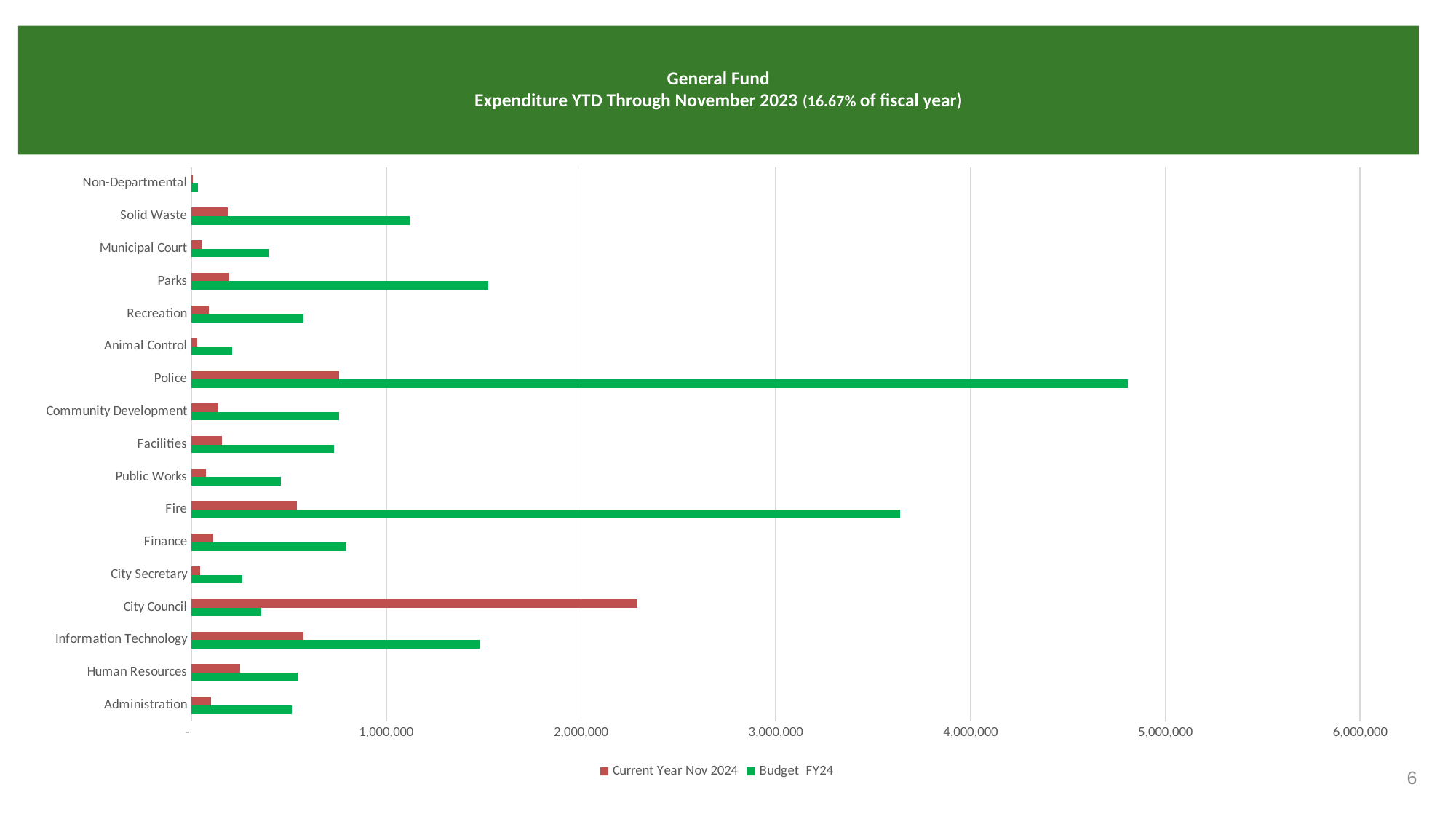
Which department has the highest Current Year Nov 2024 value? City Council What are the two series named in the legend? Current Year Nov 2024 and Budget FY24 How many departments (categories) are plotted on the chart? 17 Which department has the highest Budget FY24 value? Police Is the Current Year Nov 2024 value for City Council greater or less than 2,000,000? greater Is the Budget FY24 value for Information Technology greater or less than 2,000,000? less Is the Budget FY24 value for Fire greater or less than 3,000,000? greater How many series does the legend list? 2 For City Council, which is larger: the Current Year Nov 2024 value or the Budget FY24 value? Current Year Nov 2024 What kind of chart is shown on the slide? Bar chart Which department has the lowest Budget FY24 value? Non-Departmental